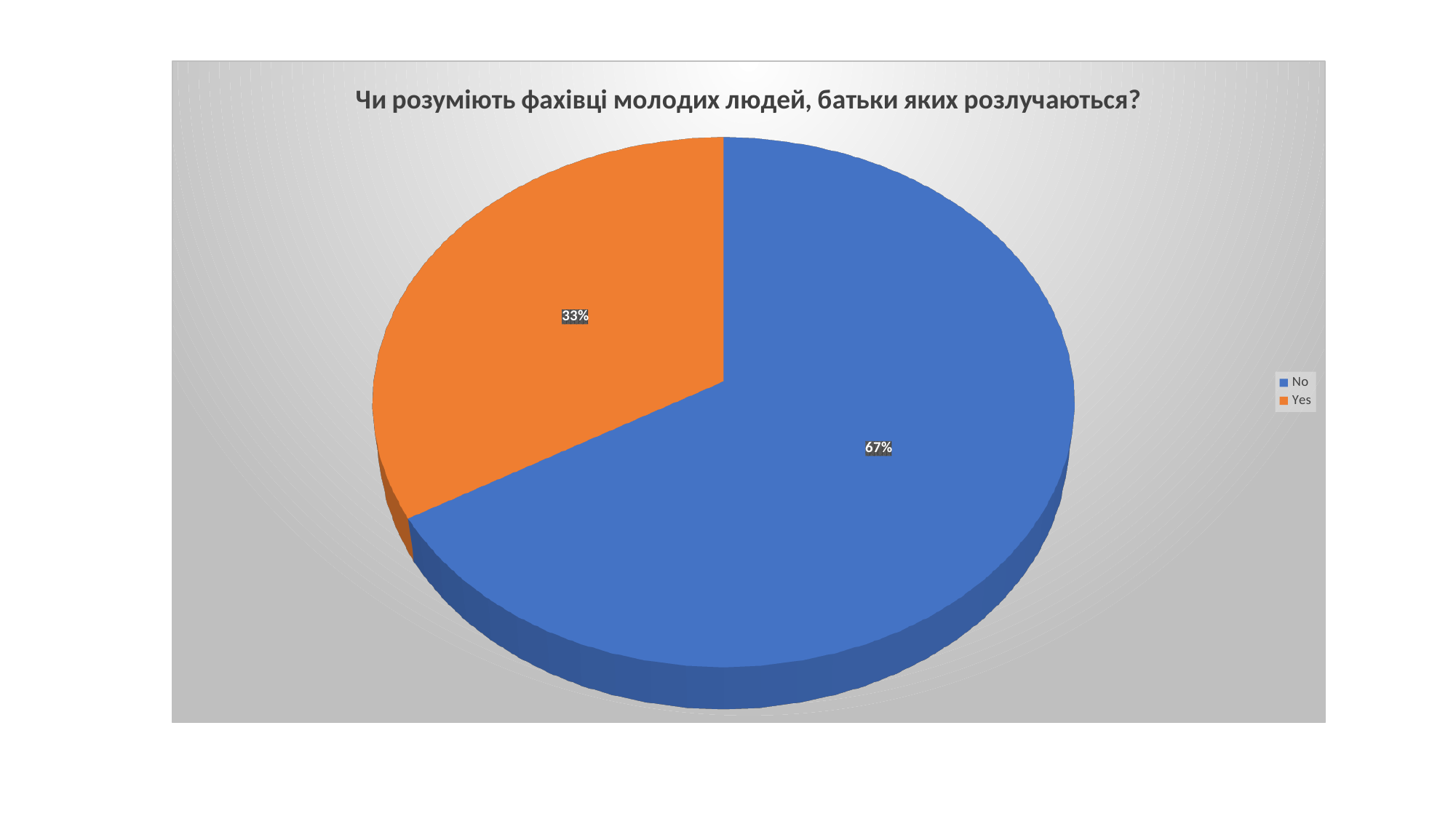
What colour is the "Yes" slice? orange How many entries does the legend list? 2 What share of the pie does the "Yes" slice represent? 33% How many slices does the pie chart have? 2 Which slice is the largest? No Which slice is the smallest? Yes What is the difference in percentage points between the "No" and "Yes" slices? 34 What is the title of the chart? Чи розуміють фахівці молодих людей, батьки яких розлучаються? What share of the pie does the "No" slice represent? 67% Which is larger, the "Yes" slice or the "No" slice? No What kind of chart is shown on the slide? pie chart